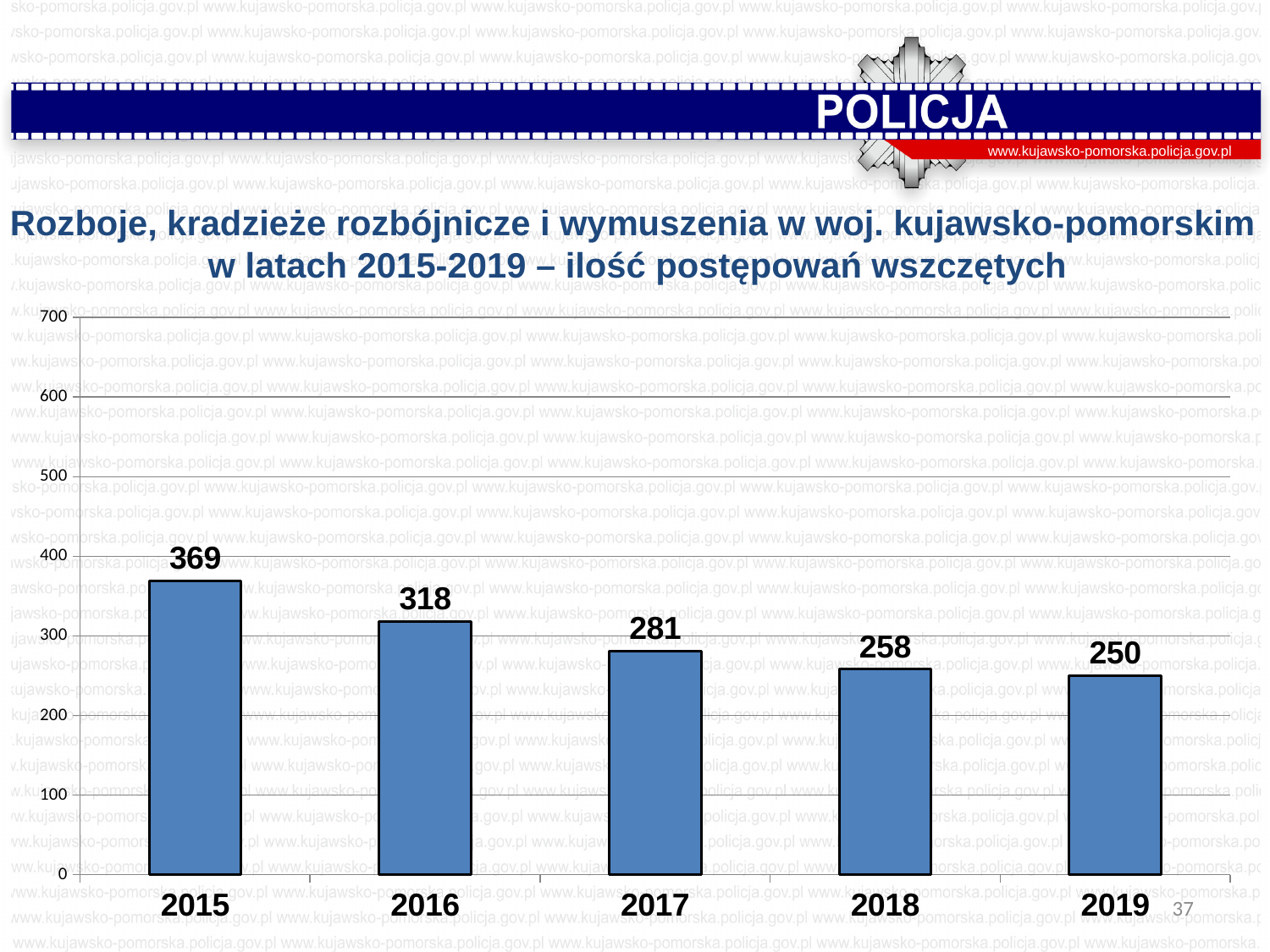
What kind of chart is shown on the slide? bar chart What is the value for 2019? 250 How many years are shown on the x axis? 5 What is the value for 2017? 281 What is the difference between the values for 2018 and 2019? 8 Which year has the highest value? 2015 Do the values rise or fall from 2015 to 2019? fall Is the value for 2018 greater or less than 300? less What is the difference between the values for 2015 and 2016? 51 Which year has the lowest value? 2019 Which is larger, the value for 2016 or the value for 2017? 2016 What is the value for 2015? 369